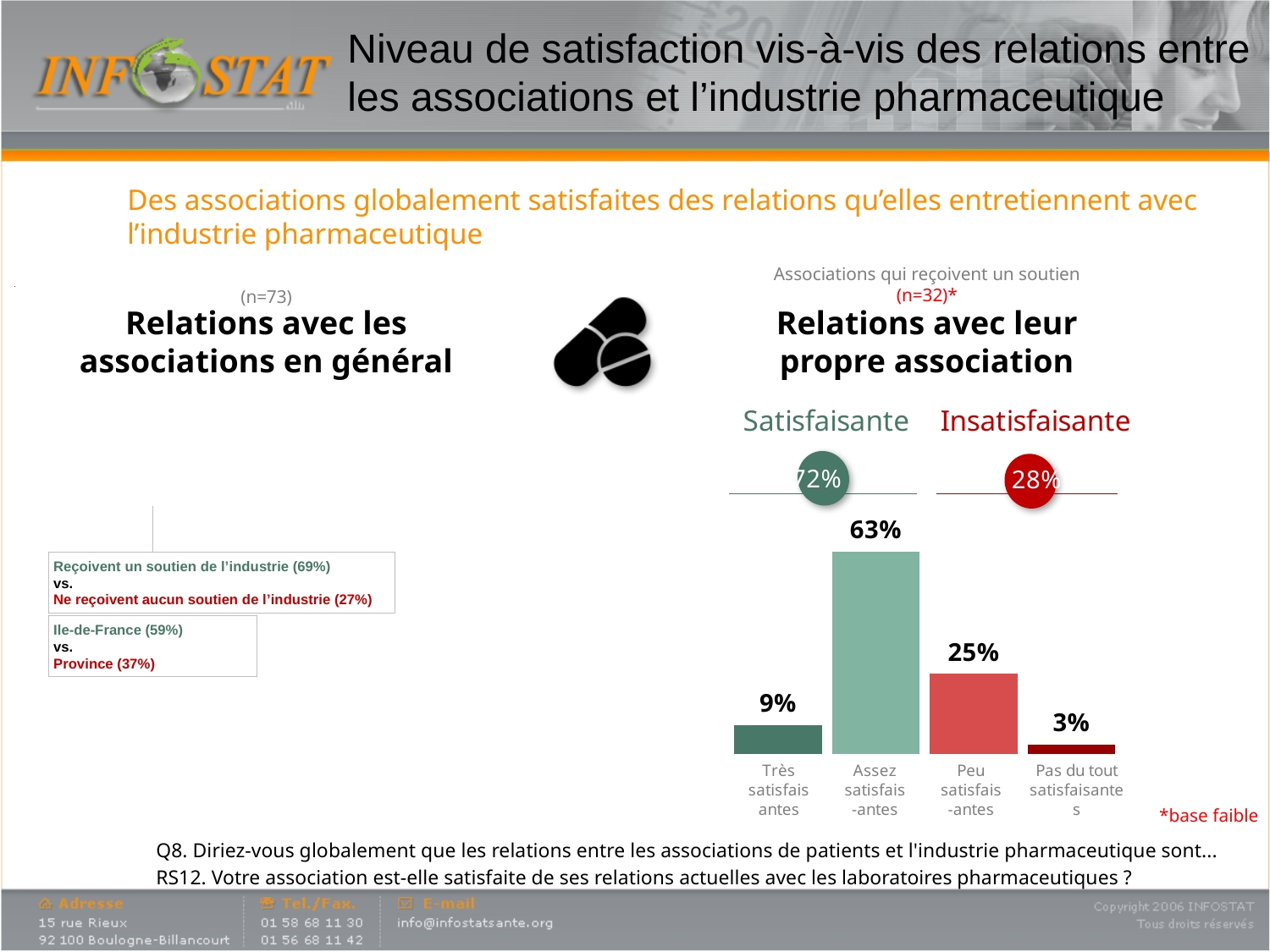
In the chart 'Relations avec leur propre association', which category has the lowest value? Pas du tout satisfaisantes In the chart 'Relations avec leur propre association', what is the value for 'Peu satisfaisantes'? 25% What kind of chart is 'Relations avec leur propre association'? Bar chart In the chart 'Relations avec leur propre association', what total share is shown for 'Insatisfaisante'? 28% How many categories are shown in the chart 'Relations avec leur propre association'? 4 In the chart 'Relations avec leur propre association', what is the value for 'Pas du tout satisfaisantes'? 3% In the chart 'Relations avec leur propre association', which category has the highest value? Assez satisfaisantes In the chart 'Relations avec leur propre association', what is the difference between 'Assez satisfaisantes' and 'Peu satisfaisantes'? 38% In the chart 'Relations avec leur propre association', which is larger: 'Très satisfaisantes' or 'Peu satisfaisantes'? Peu satisfaisantes In the chart 'Relations avec leur propre association', what is the value for 'Très satisfaisantes'? 9% In the chart 'Relations avec leur propre association', what is the value for 'Assez satisfaisantes'? 63% In the chart 'Relations avec leur propre association', what total share is shown for 'Satisfaisante'? 72%